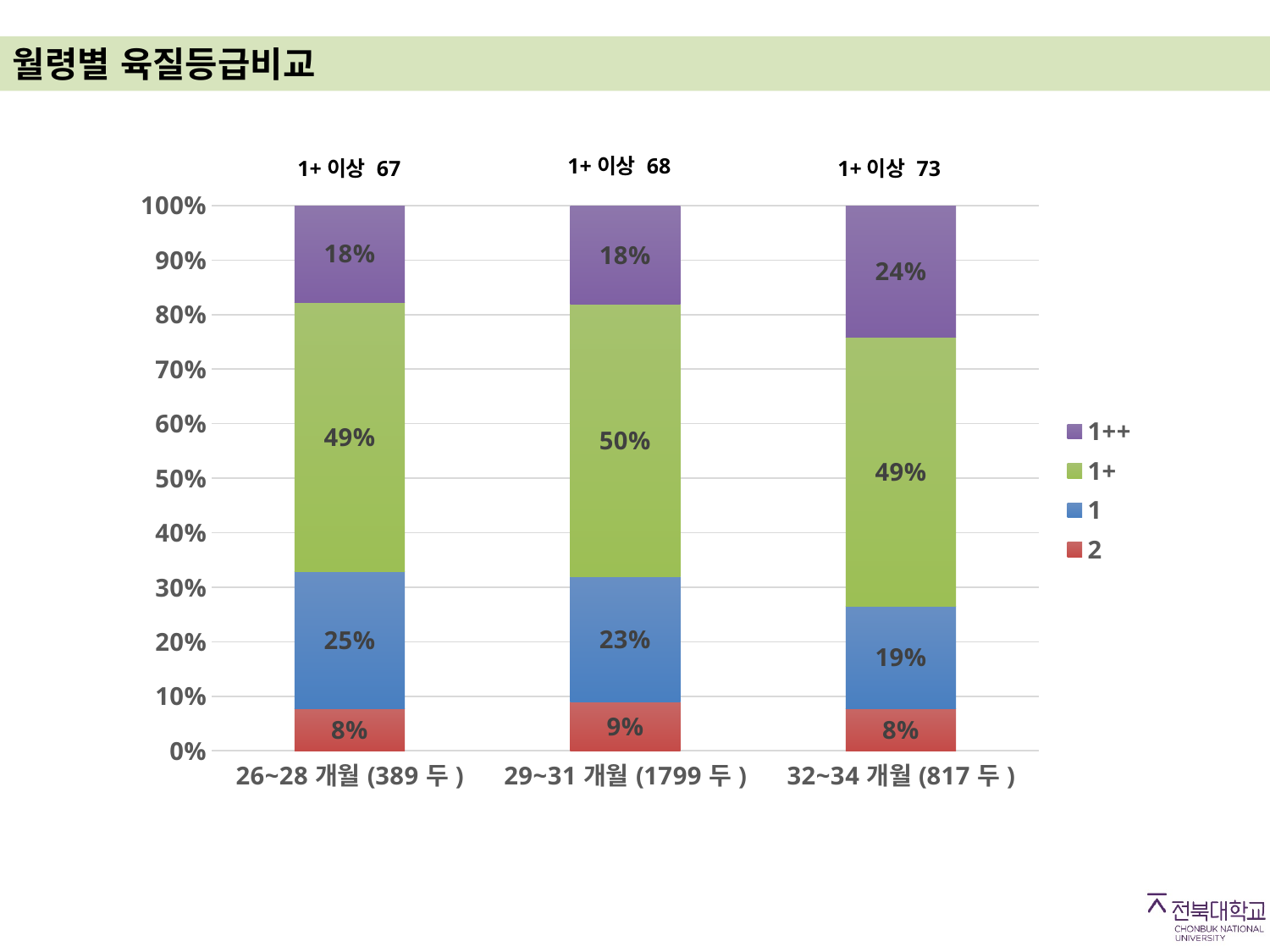
Which age group has the lowest value for the 1 series? 32~34 개월 (817 두) Which age group has the highest value for the 1++ series? 32~34 개월 (817 두) What is the '1+ 이상' figure printed above the bar for 29~31 개월 (1799 두)? 68 What kind of chart is shown on the slide? stacked bar chart What is the value of the 2 series for 26~28 개월 (389 두)? 8% What is the difference between the 1 series values for 26~28 개월 (389 두) and 32~34 개월 (817 두)? 6% Which is larger: the 1+ value for 29~31 개월 (1799 두) or the 1+ value for 26~28 개월 (389 두)? 29~31 개월 (1799 두) How many series does the legend list? 4 What is the value of the 1++ series for 32~34 개월 (817 두)? 24% How many age-group categories are plotted on the x axis? 3 Which series is shown in purple in the legend? 1++ What is the value of the 1 series for 29~31 개월 (1799 두)? 23%